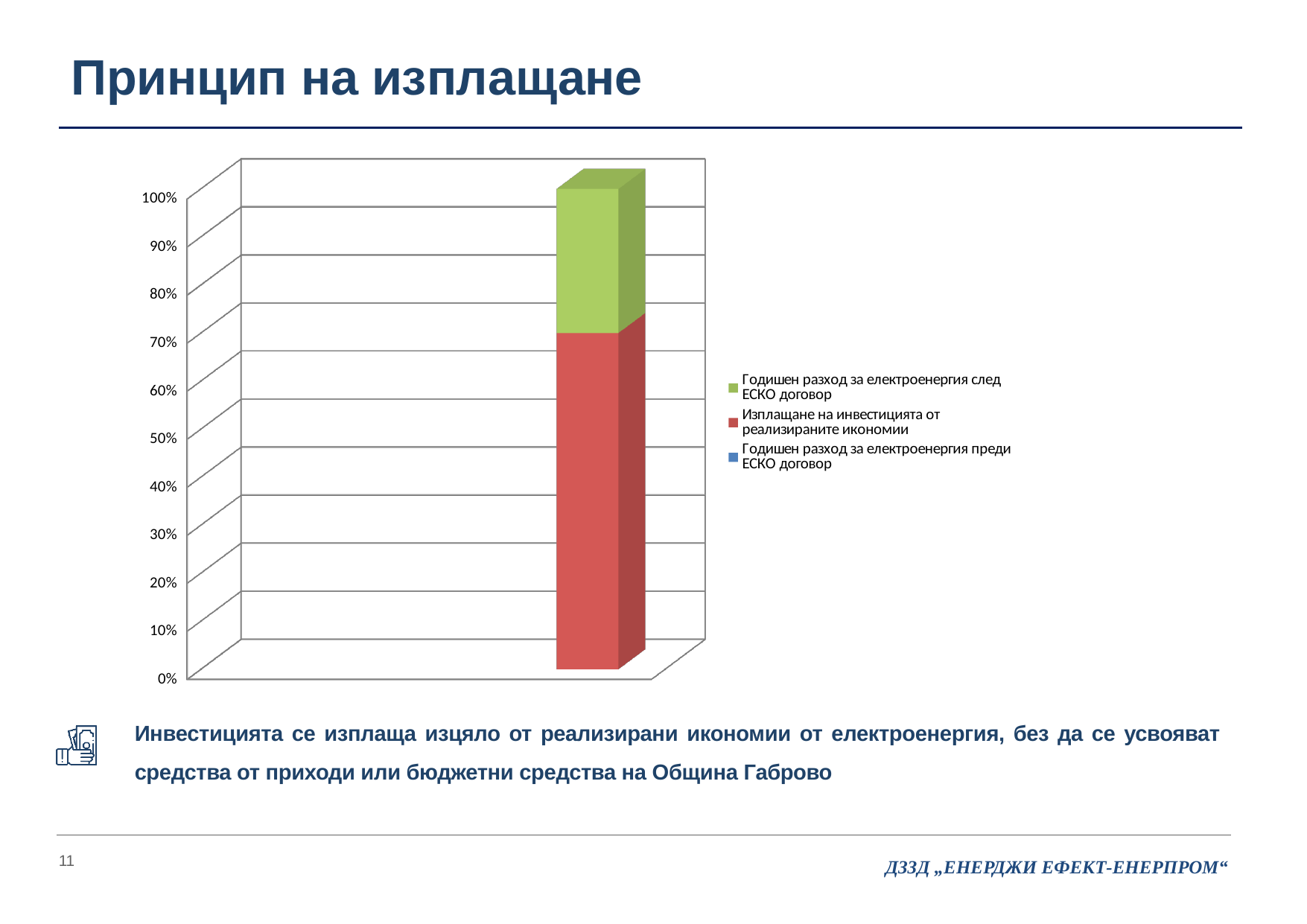
Is the value of the green segment (Годишен разход за електроенергия след ЕСКО договор) greater or less than 40%? less Is the value of the red segment (Изплащане на инвестицията от реализираните икономии) greater or less than 80%? less Is the value of the green segment (Годишен разход за електроенергия след ЕСКО договор) greater or less than 20%? greater Which segment of the bar is larger: the red one (Изплащане на инвестицията от реализираните икономии) or the green one (Годишен разход за електроенергия след ЕСКО договор)? Изплащане на инвестицията от реализираните икономии What is the highest value shown on the vertical axis of the chart? 100% Which legend entry is shown in green? Годишен разход за електроенергия след ЕСКО договор Which legend entry is shown in blue? Годишен разход за електроенергия преди ЕСКО договор How many series does the chart legend list? 3 How many bars are plotted in the chart? 1 What kind of chart is shown on the slide? Stacked bar chart